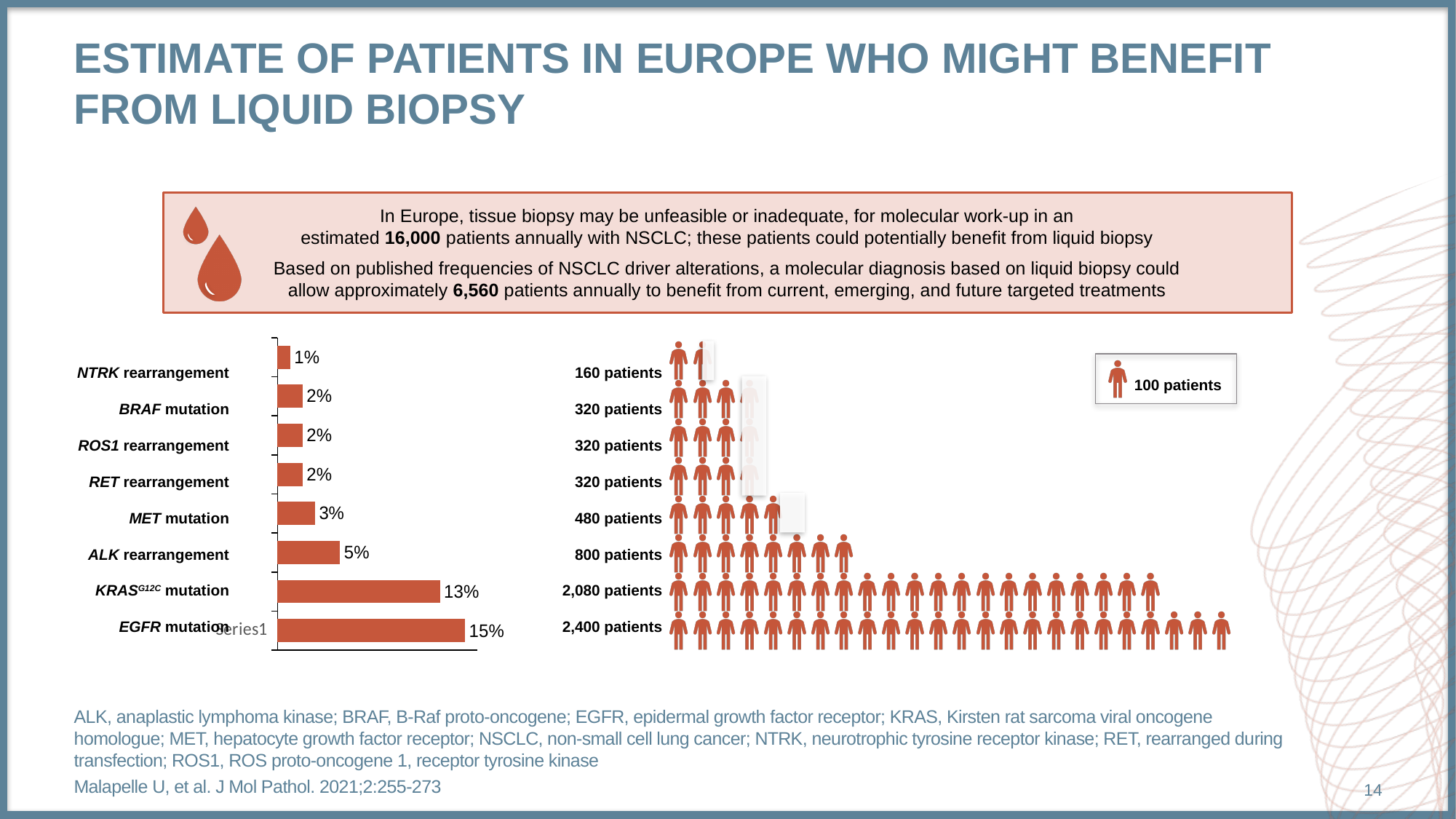
What type of chart is used to show the percentages of driver alterations? Bar chart How many categories are shown in the bar chart? 8 How many patients are shown for NTRK rearrangement in the pictogram? 160 patients Which category has the highest percentage in the bar chart? EGFR mutation What percentage is shown for EGFR mutation in the bar chart? 15% What percentage is shown for MET mutation in the bar chart? 3% What percentage is shown for ALK rearrangement in the bar chart? 5% What is the difference in percentage between EGFR mutation and KRAS G12C mutation? 2% How many patients are shown for KRAS G12C mutation in the pictogram? 2,080 patients What is the difference in patient numbers between ALK rearrangement and MET mutation in the pictogram? 320 patients Which has a higher percentage in the bar chart, ALK rearrangement or MET mutation? ALK rearrangement Which category has the lowest percentage in the bar chart? NTRK rearrangement